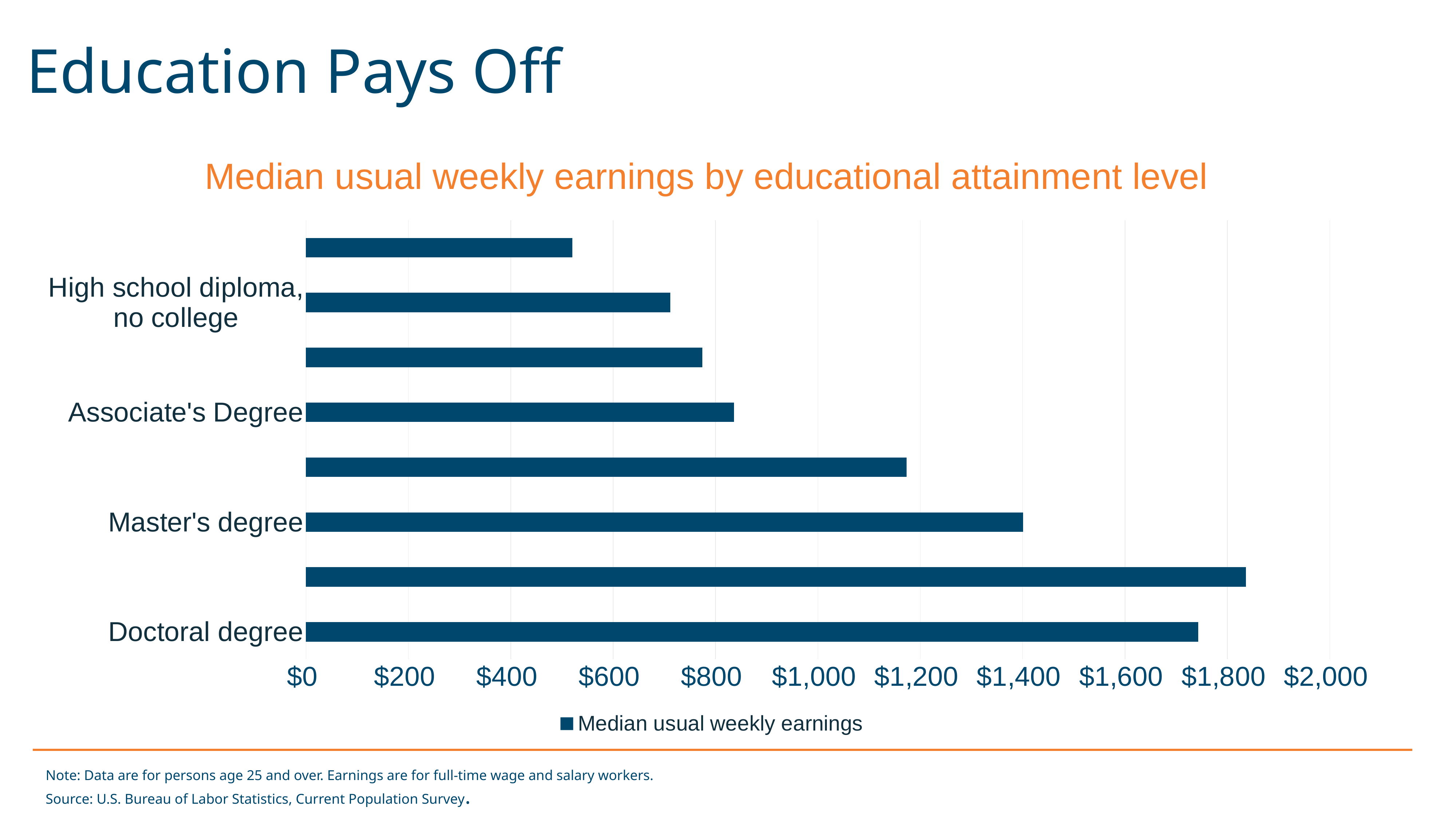
Is the value for High school diploma, no college greater or less than $600? greater What is the title of the chart? Median usual weekly earnings by educational attainment level Is the value for Master's degree greater or less than $1,200? greater Is the value for Doctoral degree greater or less than $1,800? less What kind of chart is shown on the slide? bar chart Which has higher median usual weekly earnings, Doctoral degree or Master's degree? Doctoral degree Which has higher median usual weekly earnings, Master's degree or Associate's Degree? Master's degree How many bars are plotted in the chart? 8 How many series does the legend list? 1